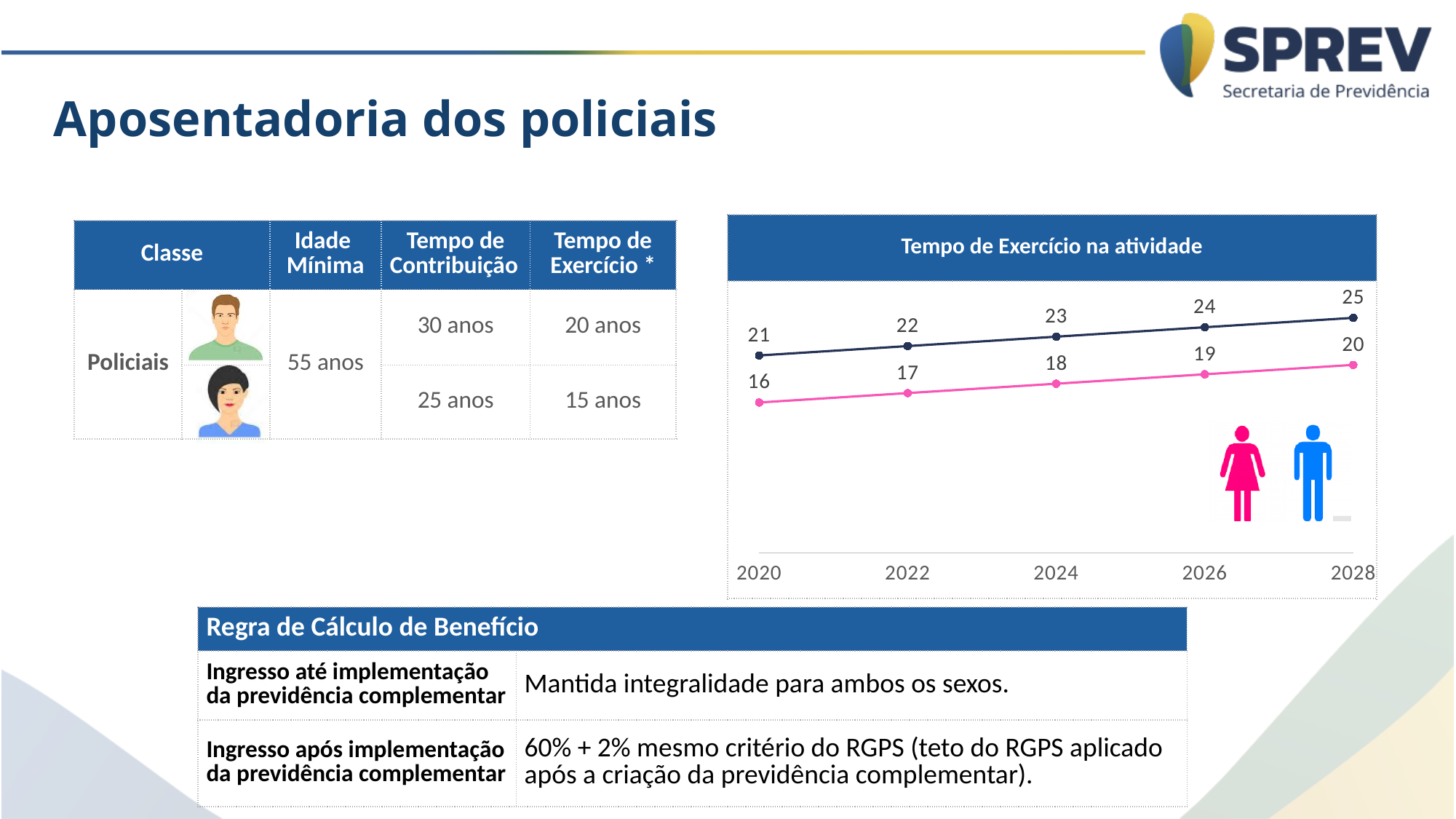
In the 'Tempo de Exercício na atividade' chart, what is the difference between the dark blue line and the pink line in 2022? 5 In the 'Tempo de Exercício na atividade' chart, do the values of the pink line rise or fall from 2020 to 2028? rise In the 'Tempo de Exercício na atividade' chart, what is the value of the pink line in 2020? 16 What type of chart is 'Tempo de Exercício na atividade'? line chart In the 'Tempo de Exercício na atividade' chart, in which year does the pink line reach its highest value? 2028 In the 'Tempo de Exercício na atividade' chart, what is the value of the dark blue line in 2028? 25 In the 'Tempo de Exercício na atividade' chart, which line has the higher value in 2024, the dark blue line or the pink line? dark blue line How many lines are plotted in the 'Tempo de Exercício na atividade' chart? 2 In the 'Tempo de Exercício na atividade' chart, in which year is the dark blue line at its lowest value? 2020 In the 'Tempo de Exercício na atividade' chart, what is the value of the pink line in 2026? 19 How many years are shown on the x axis of the 'Tempo de Exercício na atividade' chart? 5 In the 'Tempo de Exercício na atividade' chart, what is the value of the dark blue line in 2024? 23